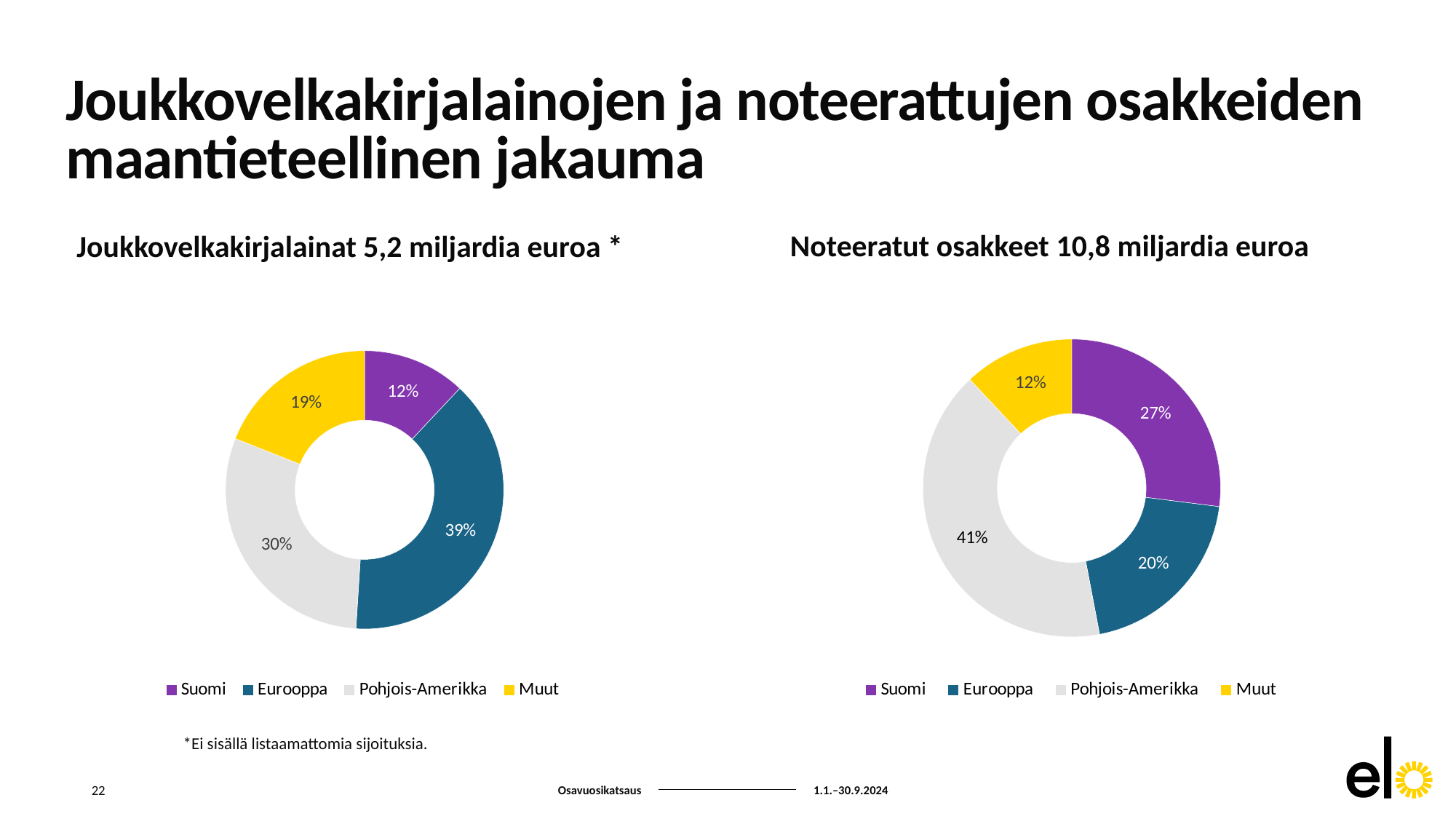
What is the title of the chart on the left side of the slide? Joukkovelkakirjalainat 5,2 miljardia euroa * In the 'Joukkovelkakirjalainat 5,2 miljardia euroa' chart, what share does Eurooppa have? 39% How many categories does the 'Joukkovelkakirjalainat 5,2 miljardia euroa' chart show? 4 What kind of chart is the 'Noteeratut osakkeet 10,8 miljardia euroa' chart? Doughnut (pie) chart Which colour represents Suomi in the legends of both charts? Purple In the 'Joukkovelkakirjalainat 5,2 miljardia euroa' chart, what share does Muut have? 19% In the 'Joukkovelkakirjalainat 5,2 miljardia euroa' chart, which category has the largest share? Eurooppa In the 'Noteeratut osakkeet 10,8 miljardia euroa' chart, which is larger, Suomi or Eurooppa? Suomi In the 'Noteeratut osakkeet 10,8 miljardia euroa' chart, what is the difference between the shares of Pohjois-Amerikka and Eurooppa? 21 percentage points In the 'Noteeratut osakkeet 10,8 miljardia euroa' chart, which category has the smallest share? Muut In the 'Noteeratut osakkeet 10,8 miljardia euroa' chart, what share does Pohjois-Amerikka have? 41% In the 'Joukkovelkakirjalainat 5,2 miljardia euroa' chart, what is the difference between the shares of Pohjois-Amerikka and Suomi? 18 percentage points